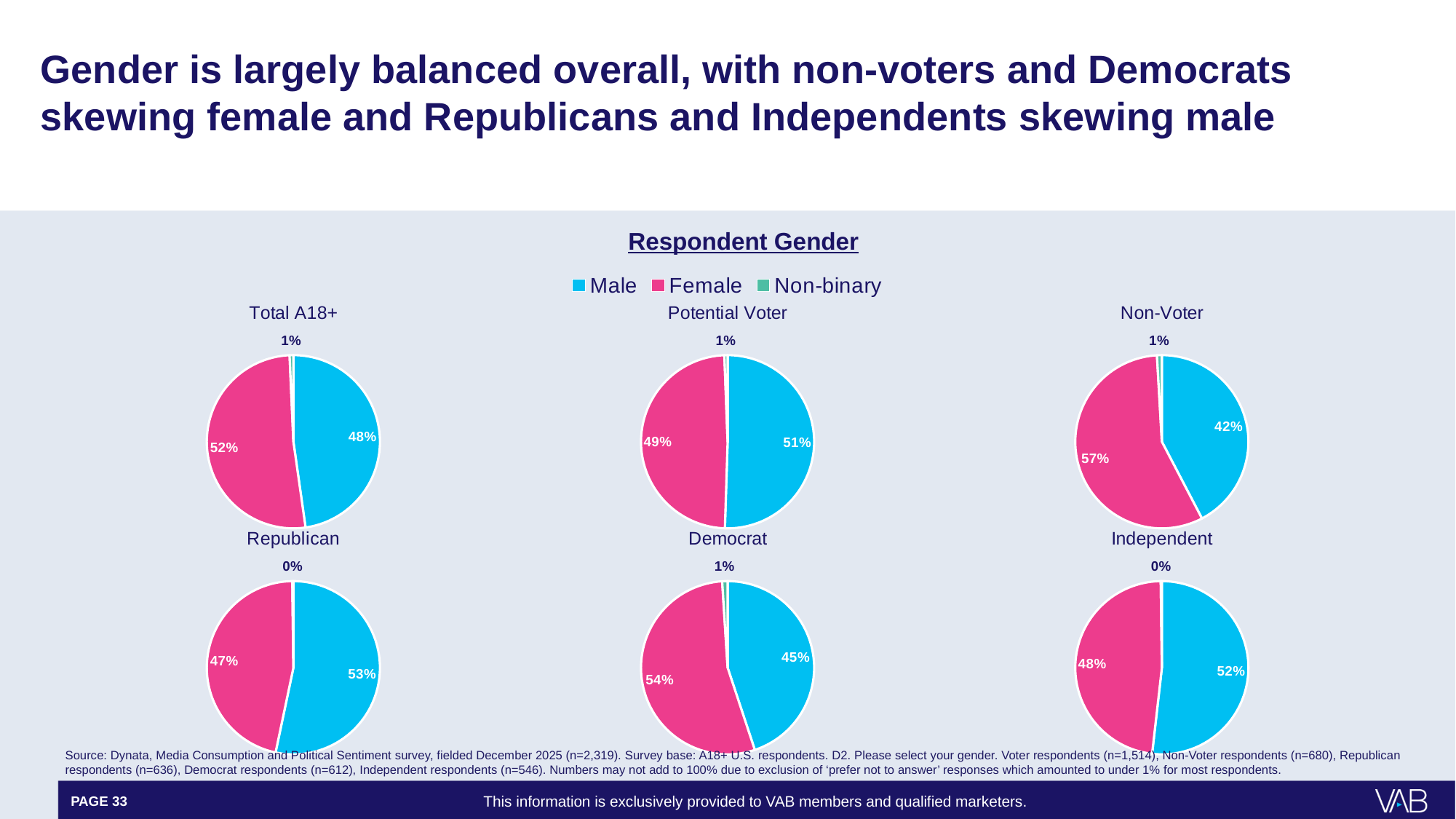
In the Democrat pie chart, what is the difference between the Female and Male shares? 9% In the Non-Voter pie chart, what share of respondents are Female? 57% In the Total A18+ pie chart, what share of respondents are Male? 48% In the Non-Voter pie chart, which gender has the smallest share? Non-binary In the Democrat pie chart, what share of respondents are Female? 54% How many pie charts are shown on the slide? 6 How many series does the legend of the Respondent Gender charts list? 3 In the Republican pie chart, what share of respondents are Male? 53% What kind of chart is used to show Respondent Gender for each group? Pie chart In the Non-Voter pie chart, is the Male share larger or smaller than the Female share? smaller In the Independent pie chart, what share of respondents are Non-binary? 0% In the Potential Voter pie chart, which gender has the largest share? Male